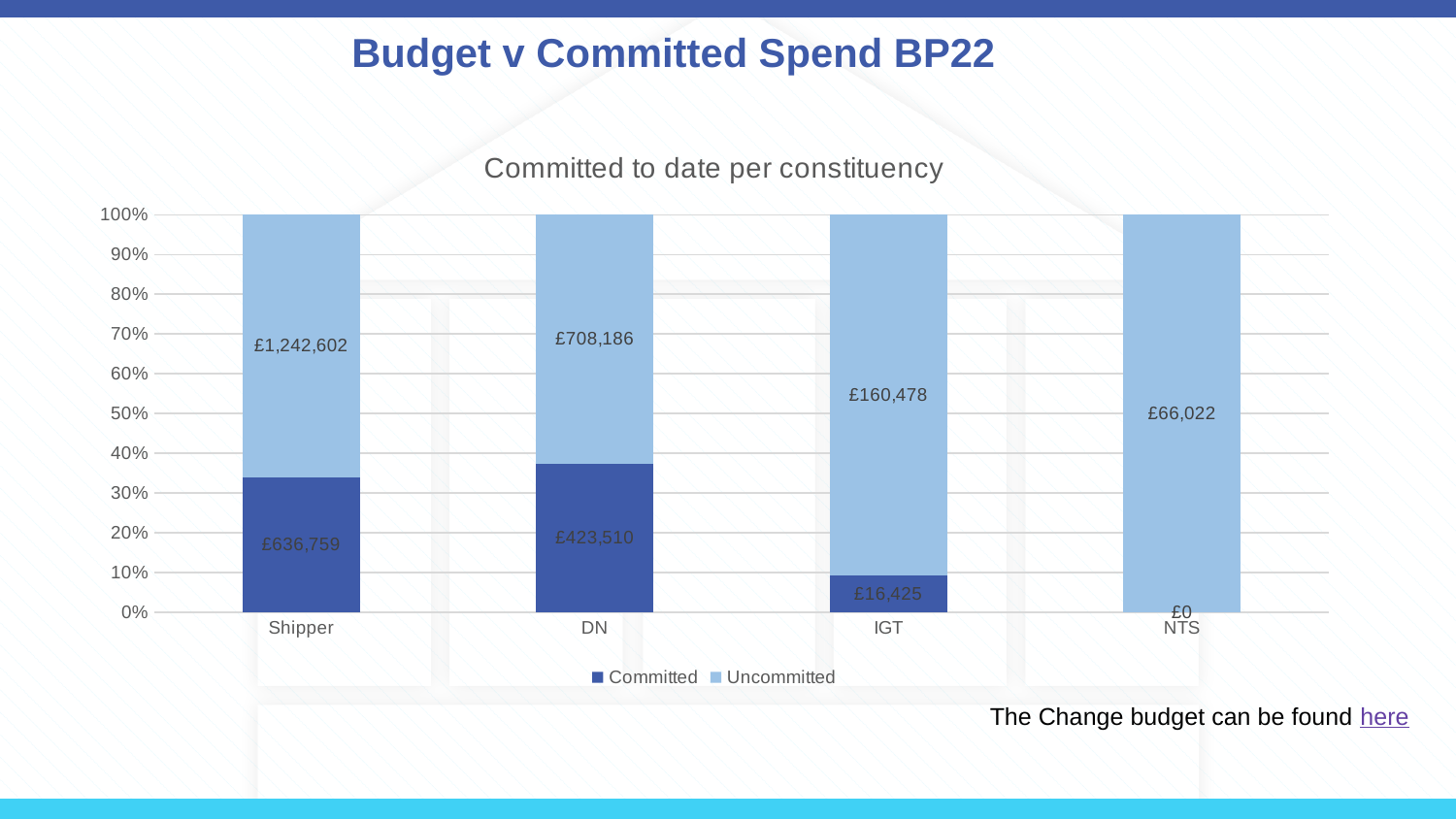
Which is larger, the Committed value for DN or the Committed value for Shipper? Shipper Which constituency has the highest Uncommitted value? Shipper What is the Committed value for Shipper? £636,759 How many series does the legend list? 2 Is the Committed share of the Shipper bar greater or less than 40%? less What is the Uncommitted value for DN? £708,186 What is the difference between the Uncommitted and Committed values for IGT? £144,053 What kind of chart is shown? Stacked bar chart What is the total of the Committed and Uncommitted values for DN? £1,131,696 Which constituency has the lowest Committed value? NTS How many constituencies are shown on the x axis? 4 What is the Committed value for NTS? £0